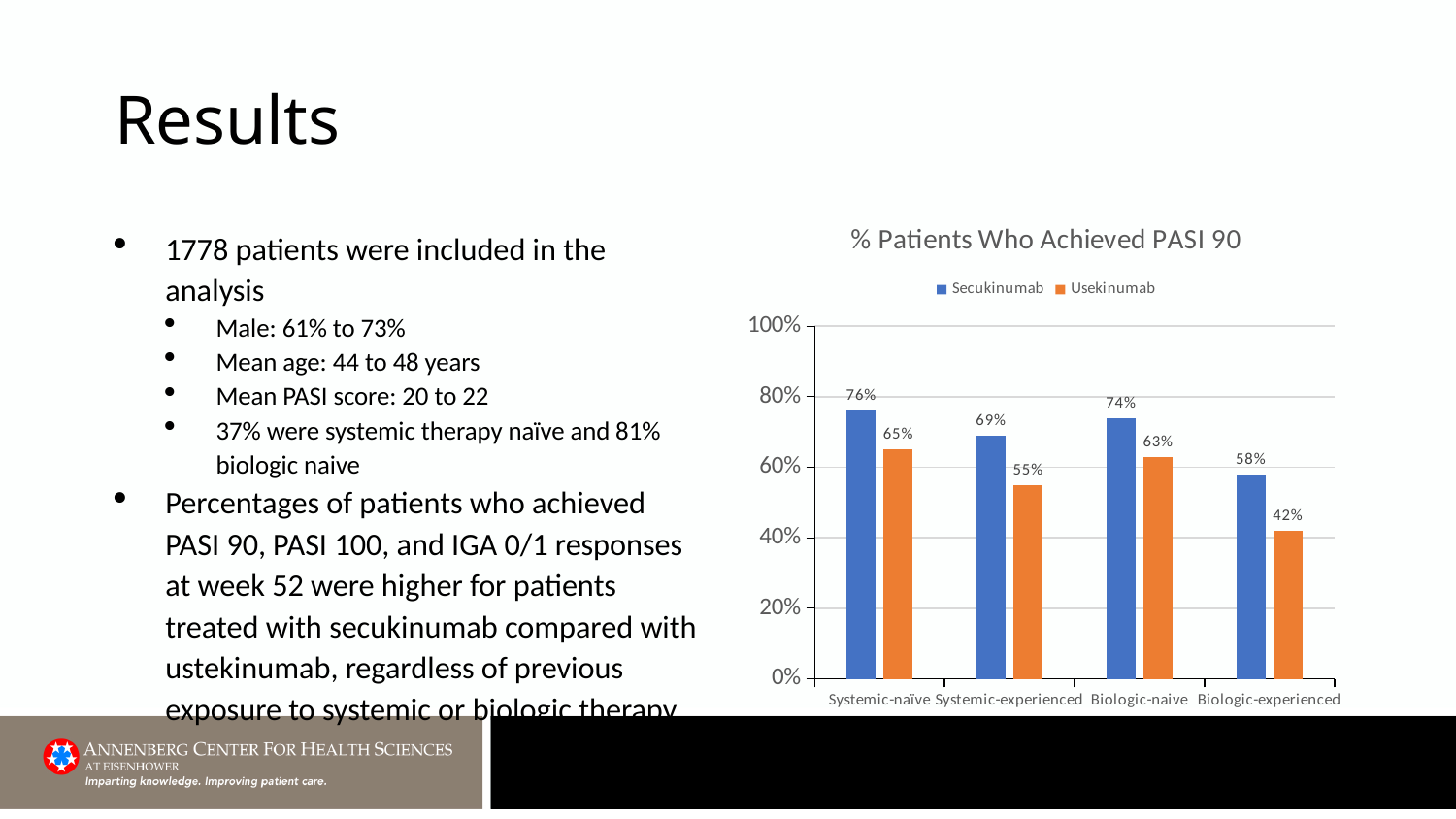
What is the Usekinumab value for the Systemic-experienced category? 55% What percentage of Systemic-naïve patients achieved PASI 90 with Secukinumab? 76% Is the Usekinumab value for Biologic-experienced greater or less than 60%? less How many categories are shown on the x axis of the chart? 4 How many series does the chart legend list? 2 What is the difference between the Secukinumab values for Systemic-naïve and Biologic-naive patients? 2% What type of chart is shown on the slide? Bar chart Which is larger: the Secukinumab value for Biologic-naive or the Usekinumab value for Systemic-naïve? Secukinumab value for Biologic-naive What is the difference between the Secukinumab and Usekinumab values for Biologic-experienced patients? 16% Which category has the lowest Usekinumab value? Biologic-experienced Which category has the highest Secukinumab value? Systemic-naïve What percentage of Biologic-experienced patients achieved PASI 90 with Usekinumab? 42%